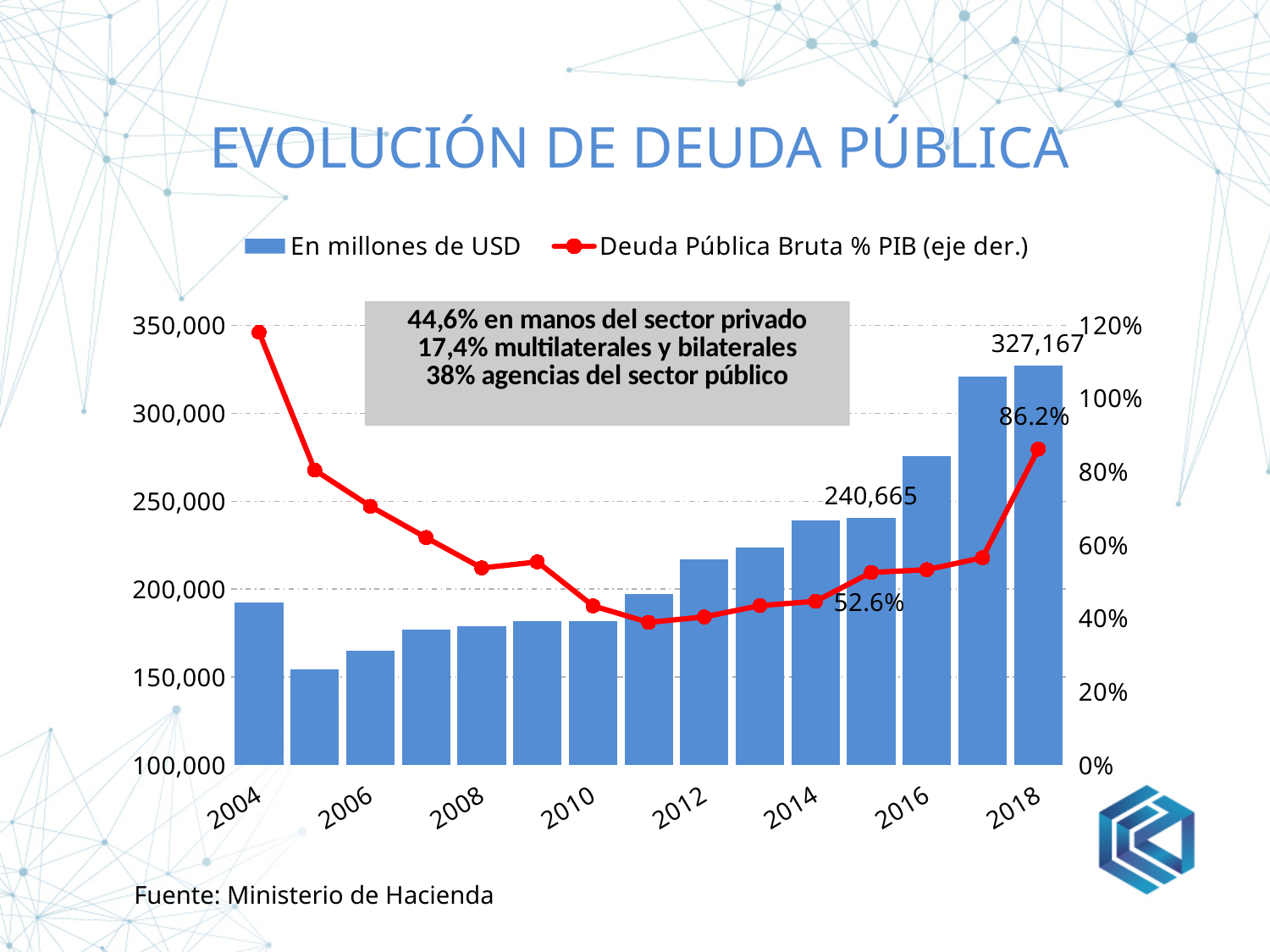
What kind of chart is shown on the slide? Combination bar and line chart Which year has the lowest 'En millones de USD' bar? 2005 By how much does the 'En millones de USD' value for 2018 exceed the value for 2015? 86,502 Which year has the highest 'En millones de USD' bar? 2018 In which year is the 'Deuda Pública Bruta % PIB' line at its highest? 2004 Is the 'En millones de USD' value for 2005 greater or less than 200,000? less What is the 'Deuda Pública Bruta % PIB' value for 2018? 86.2% How many series does the legend list? 2 What is the value of the 'En millones de USD' bar for 2018? 327,167 What is the 'Deuda Pública Bruta % PIB' value for 2015? 52.6% How many years are shown on the x axis of the chart? 15 What is the value of the 'En millones de USD' bar for 2015? 240,665